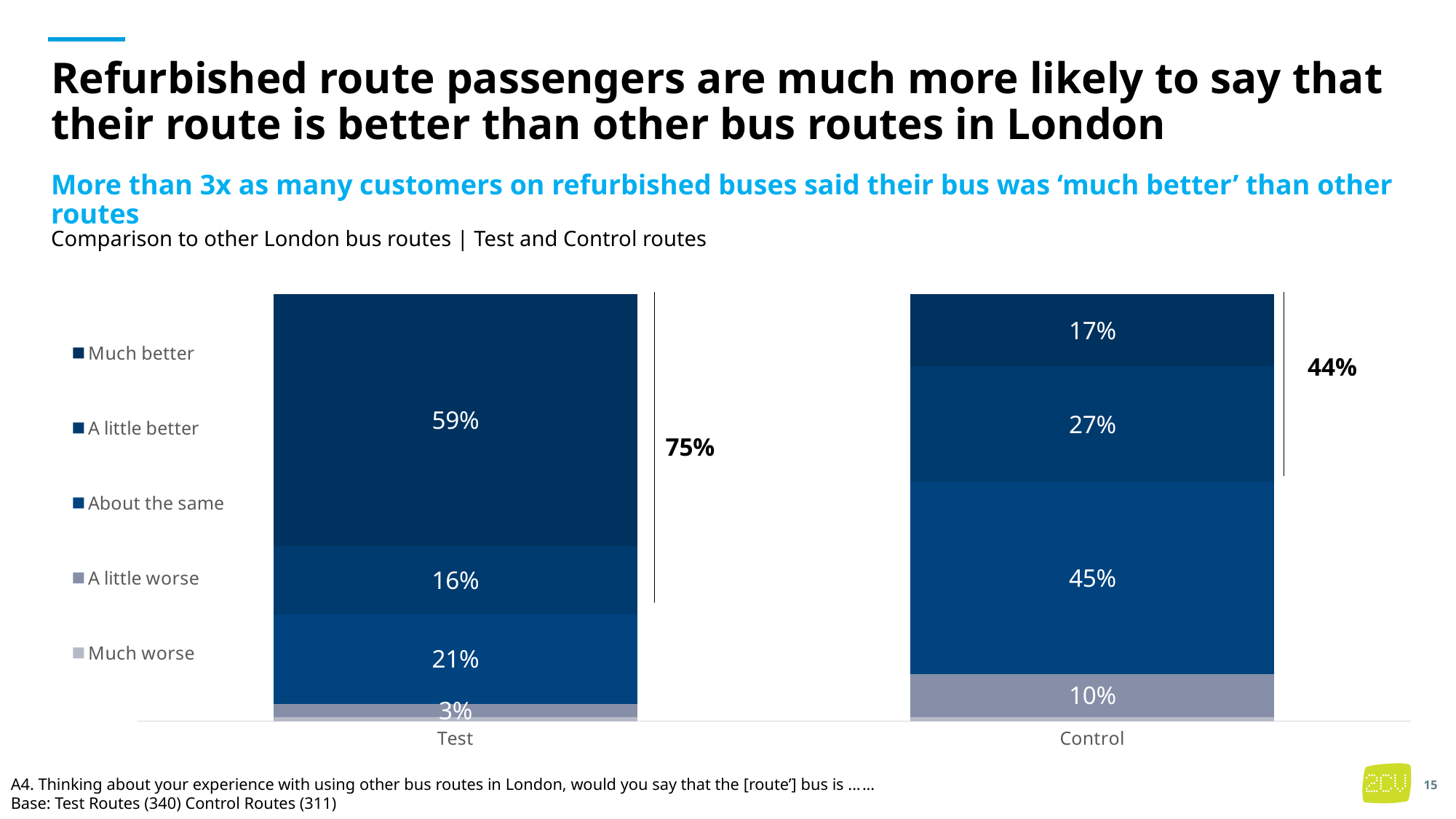
What type of chart is shown on the slide? Stacked bar chart What percentage of Test route passengers said their route is 'A little worse'? 3% What percentage of Control route passengers said their route is 'A little better'? 27% How many response categories does the legend list? 5 What percentage of Test route passengers said their route is 'Much better'? 59% Which response category is the largest segment in the Test bar? Much better How many bars are shown in the chart? 2 What is the difference in percentage points between Test and Control for 'Much better'? 42 percentage points What is the combined percentage of 'Much better' and 'A little better' responses for the Test routes, as shown by the bracket label? 75% Which route group has the larger share of 'About the same' responses, Test or Control? Control What percentage of Control route passengers said their route is 'About the same'? 45% What percentage of Control route passengers said their route is 'Much better'? 17%